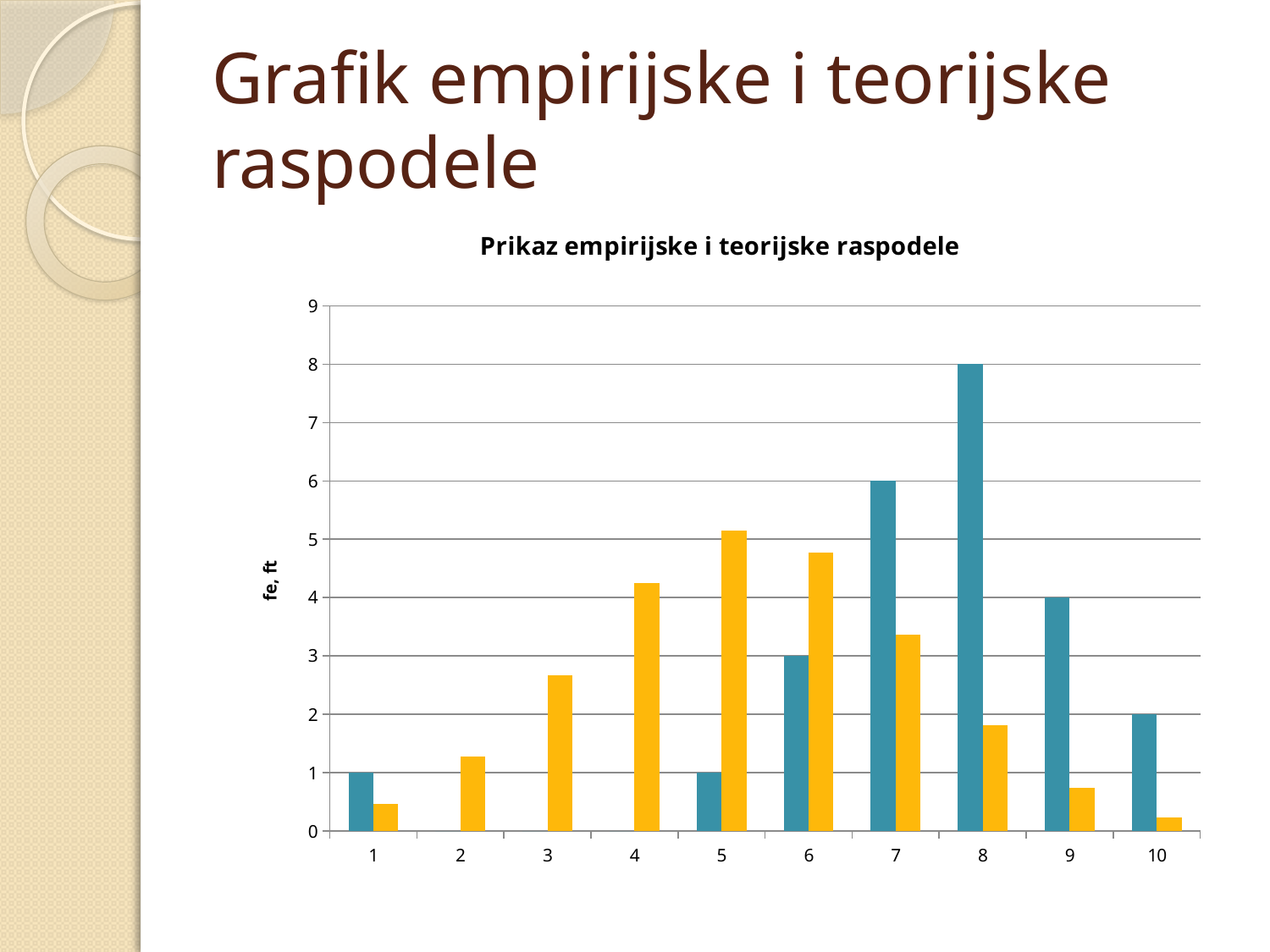
What is the difference between the blue bar for category 8 and the blue bar for category 7? 2 What is the label on the y axis of the chart? fe, ft What kind of chart is shown on the slide? bar chart For category 7, which bar is taller, the blue one or the yellow one? the blue one What is the value of the blue bar for category 7? 6 How many categories are shown on the x axis of the chart? 10 What is the value of the blue bar for category 8? 8 Which category has the tallest blue bar? 8 Is the value of the yellow bar for category 10 greater or less than 1? less What is the value of the blue bar for category 9? 4 For category 6, which bar is taller, the blue one or the yellow one? the yellow one Is the value of the yellow bar for category 5 greater or less than 4? greater